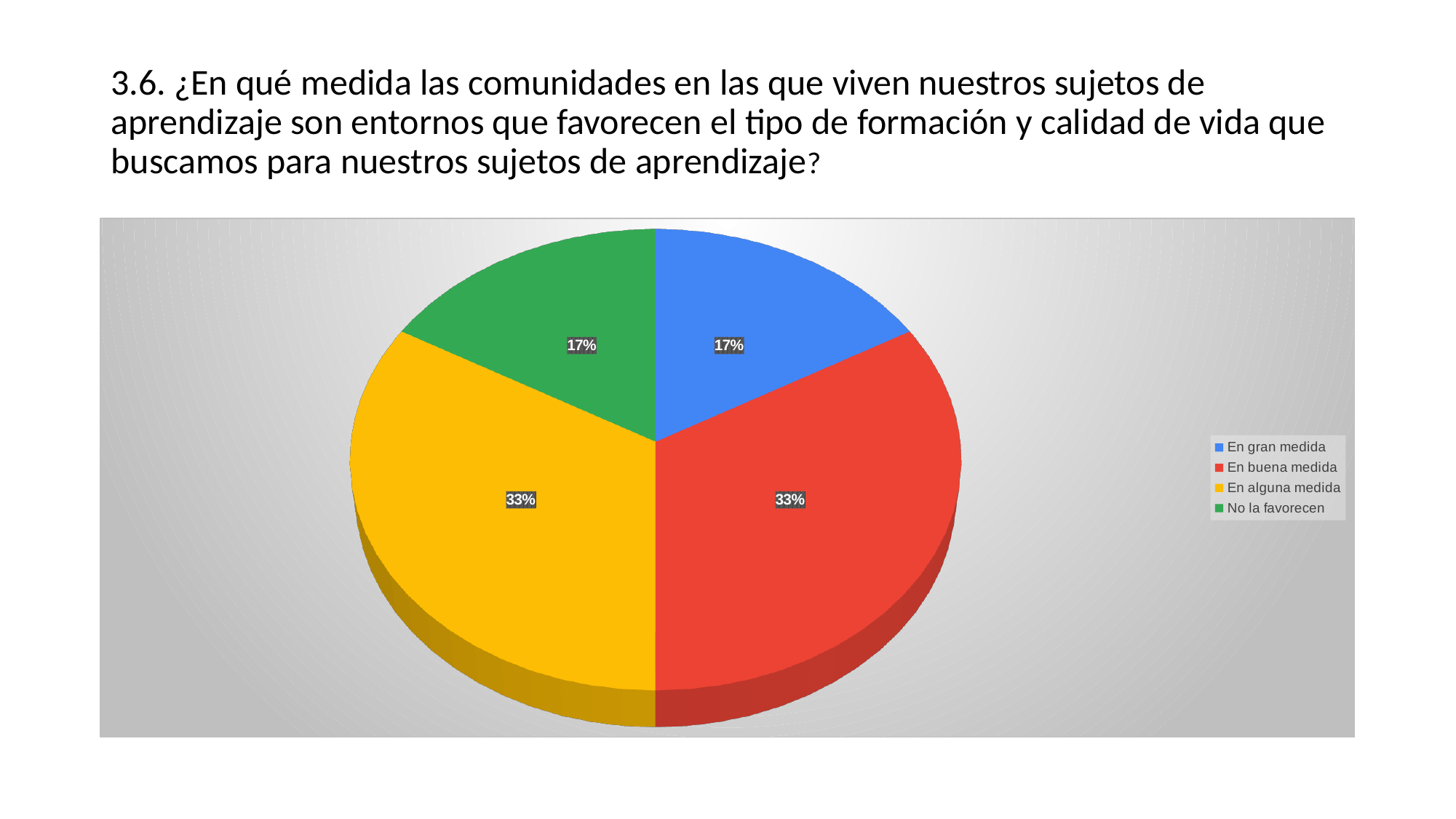
What share of the pie does "No la favorecen" represent? 17% What share of the pie does "En alguna medida" represent? 33% Which legend entry is shown in green? No la favorecen What share of the pie does "En buena medida" represent? 33% How many slices does the pie chart have? 4 What colour is the slice for "En alguna medida"? yellow What is the difference in percentage points between the share for "En alguna medida" and the share for "No la favorecen"? 16 Which is larger, the share for "No la favorecen" or the share for "En alguna medida"? En alguna medida How many entries does the legend list? 4 Which is larger, the share for "En buena medida" or the share for "En gran medida"? En buena medida What type of chart is shown on the slide? pie chart